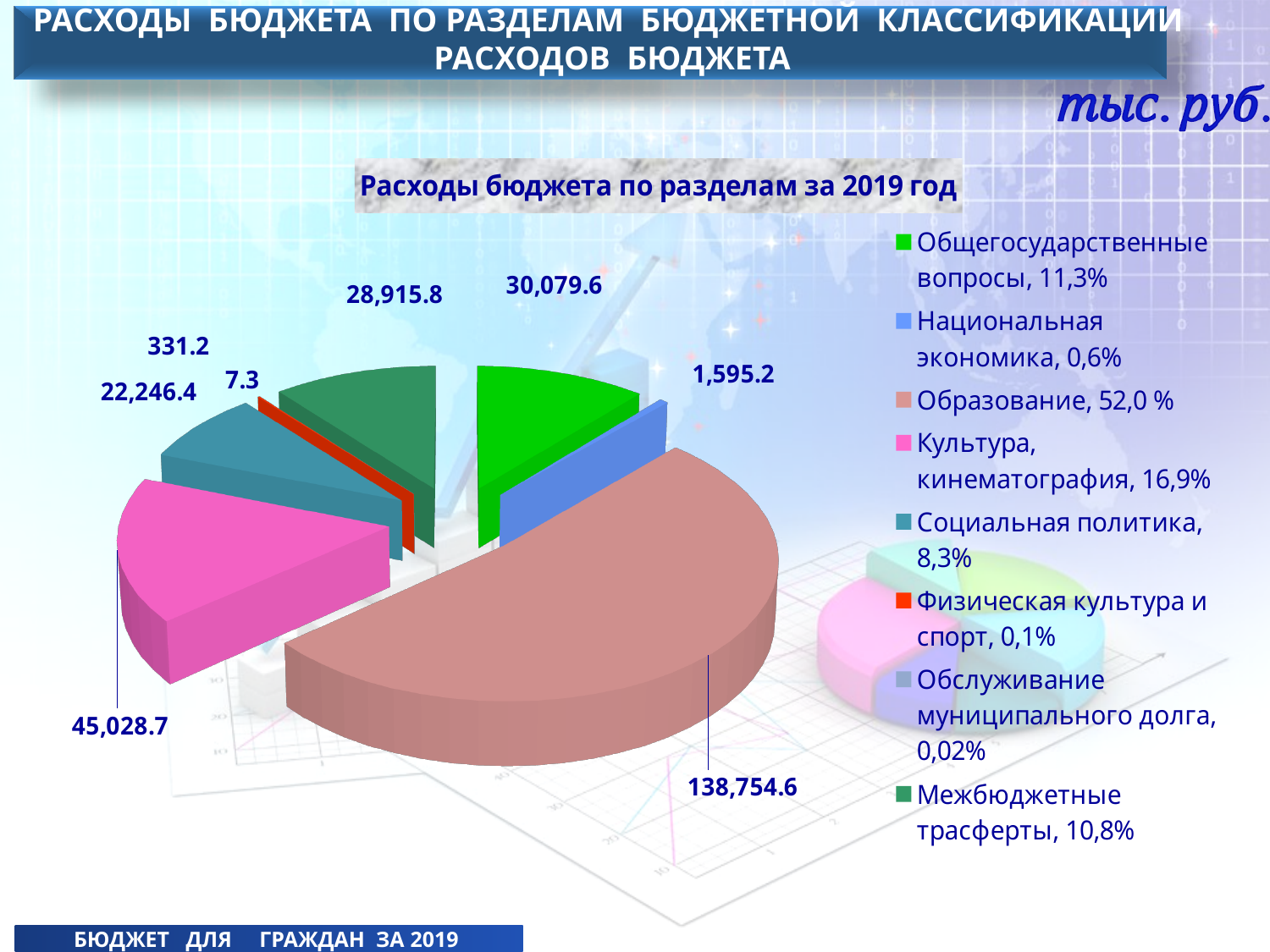
How many categories does the legend of the pie chart list? 8 What is the difference between the values for Общегосударственные вопросы and Межбюджетные трасферты? 1,163.8 What is the title of the chart? Расходы бюджета по разделам за 2019 год What is the value shown for Социальная политика? 22,246.4 What share of the pie does Культура, кинематография represent? 16,9% What is the value shown for Образование? 138,754.6 What type of chart is shown on the slide? pie chart Which is larger, the value for Общегосударственные вопросы or the value for Межбюджетные трасферты? Общегосударственные вопросы Which category has the largest share of the pie? Образование Which category has the smallest share of the pie? Обслуживание муниципального долга What is the value shown for Межбюджетные трасферты? 28,915.8 What is the value shown for Культура, кинематография? 45,028.7